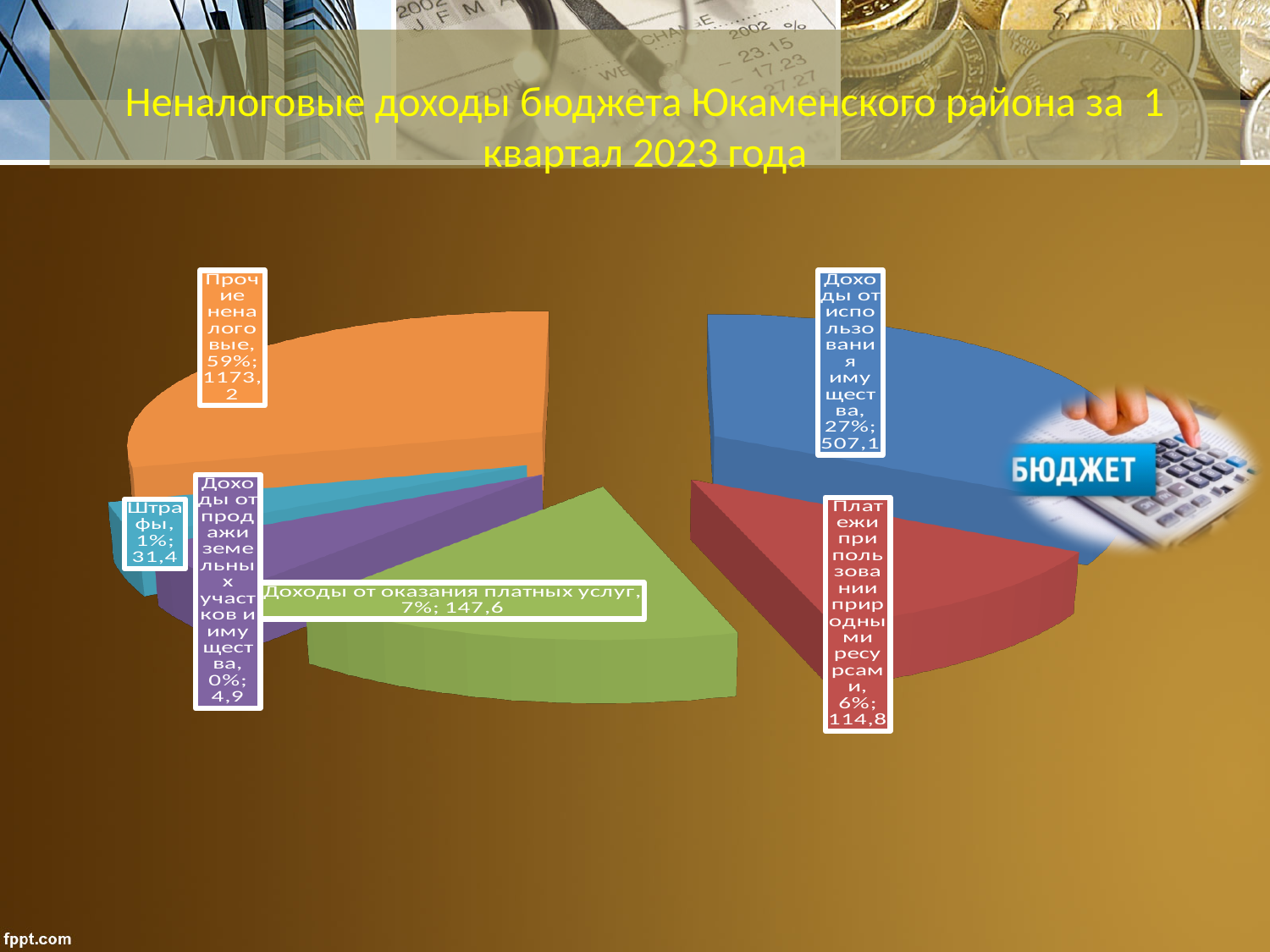
Which category has the smallest value? Доходы от продажи земельных участков и имущества What is the difference between the values for Прочие неналоговые and Доходы от использования имущества? 666,1 Which is larger: Доходы от оказания платных услуг or Платежи при пользовании природными ресурсами? Доходы от оказания платных услуг What is the value for Доходы от оказания платных услуг? 147,6 What share of the pie does Прочие неналоговые represent? 59% Which category has the largest value? Прочие неналоговые How many categories are shown in the pie chart? 6 What is the value for Штрафы? 31,4 What is the value for Доходы от использования имущества? 507,1 What kind of chart is shown on the slide? Pie chart What is the value for Прочие неналоговые? 1173,2 What share of the pie does Платежи при пользовании природными ресурсами represent? 6%